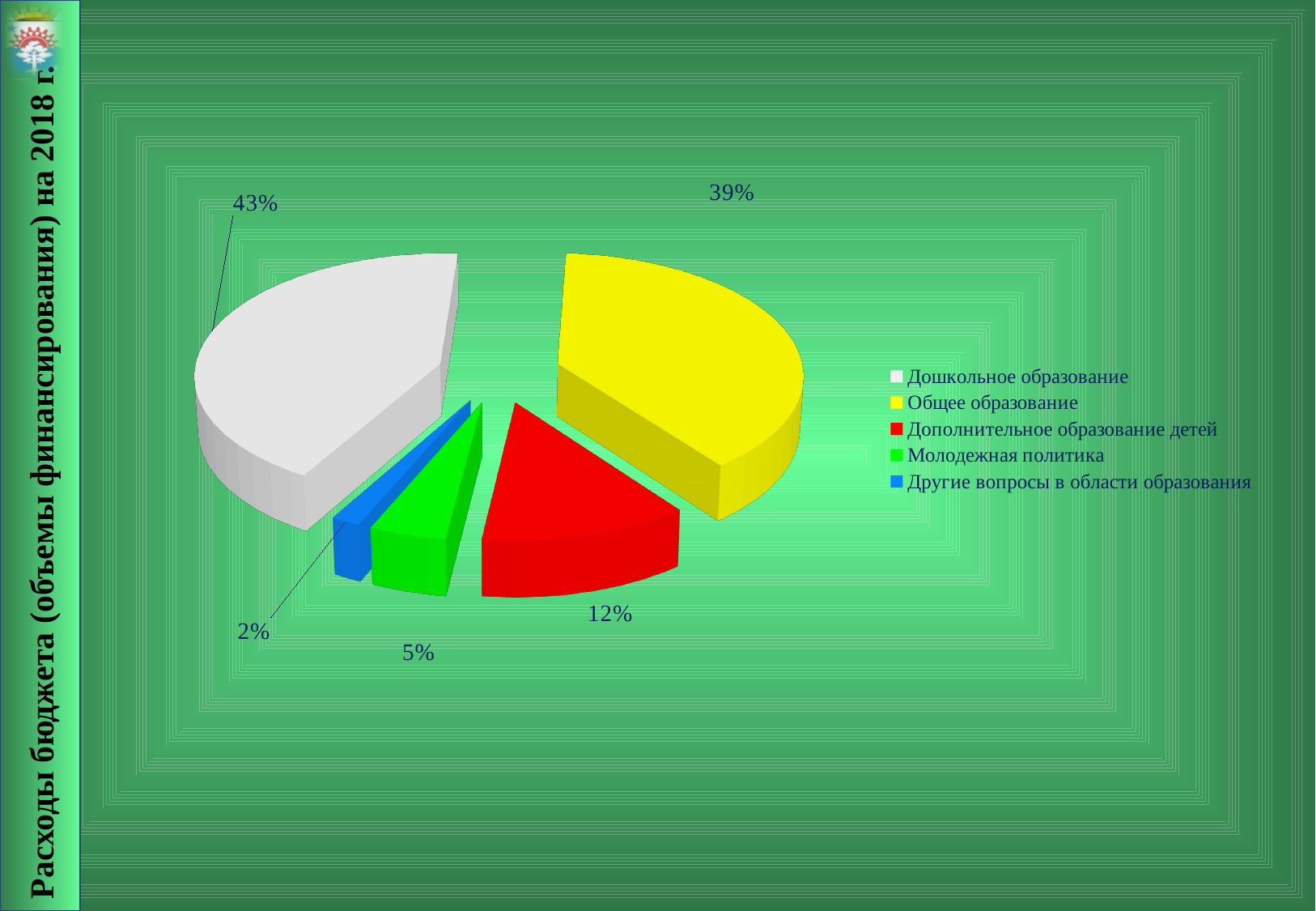
What share of the pie does Другие вопросы в области образования have? 2% What share of the pie does Молодежная политика have? 5% Which is larger, the share for Дополнительное образование детей or the share for Молодежная политика? Дополнительное образование детей What share of the pie does Дополнительное образование детей have? 12% Which category has the largest share of the pie? Дошкольное образование What is the difference in percentage points between Дошкольное образование and Общее образование? 4 How many categories does the legend list? 5 What kind of chart is shown on the slide? Pie chart Which category has the smallest share of the pie? Другие вопросы в области образования What colour is the slice for Общее образование? Yellow